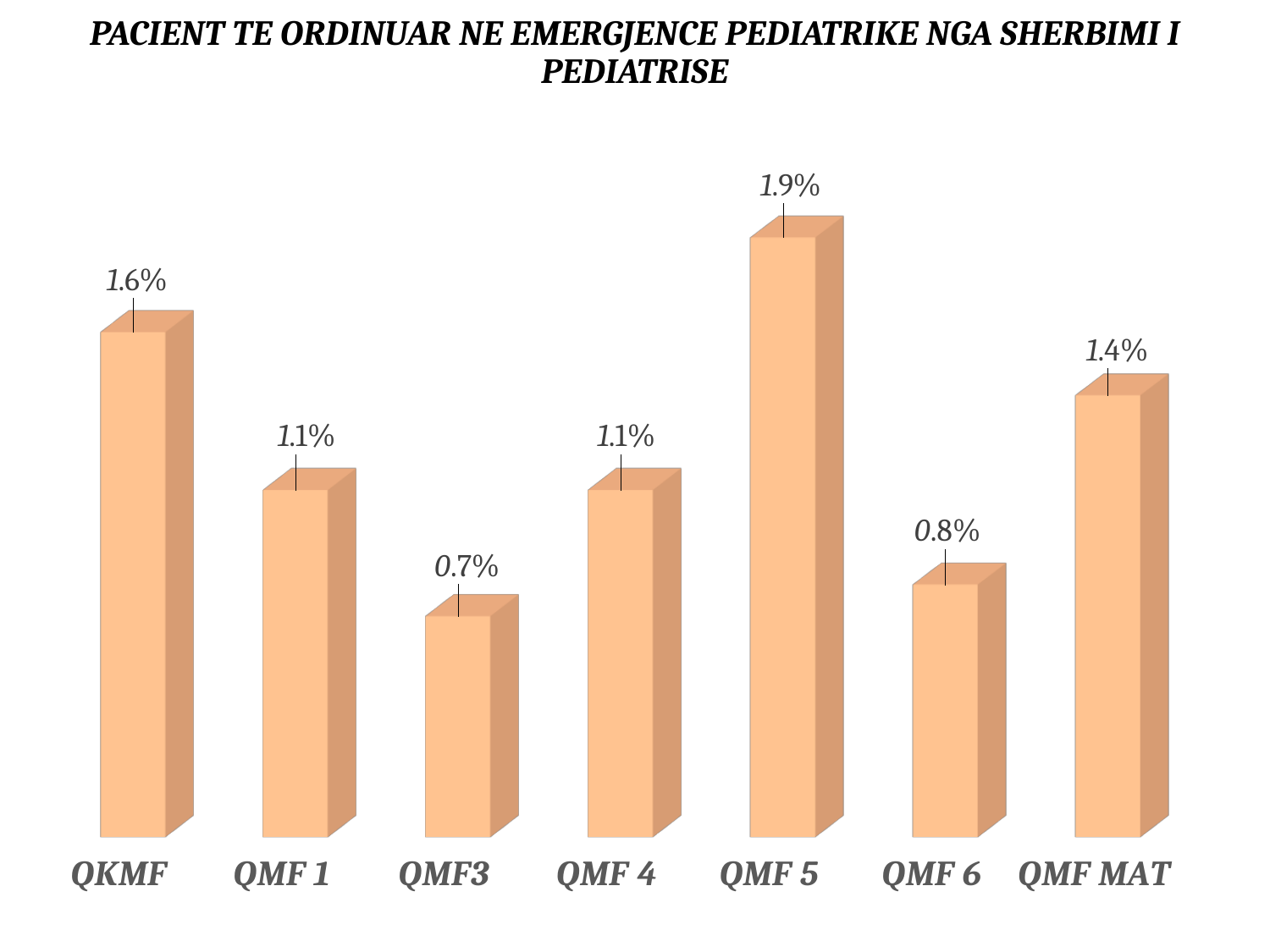
How many categories are shown on the chart? 7 What is the difference between the values for QKMF and QMF MAT? 0.2% What is the difference between the values for QMF 5 and QMF3? 1.2% What is the value for QMF 6? 0.8% What is the title of the chart? PACIENT TE ORDINUAR NE EMERGJENCE PEDIATRIKE NGA SHERBIMI I PEDIATRISE What is the value for QMF MAT? 1.4% What kind of chart is shown on the slide? Bar chart What is the value for QKMF? 1.6% What is the value for QMF 5? 1.9% Which category has the highest value? QMF 5 Which is larger, the value for QMF 1 or the value for QMF 6? QMF 1 Which category has the lowest value? QMF3